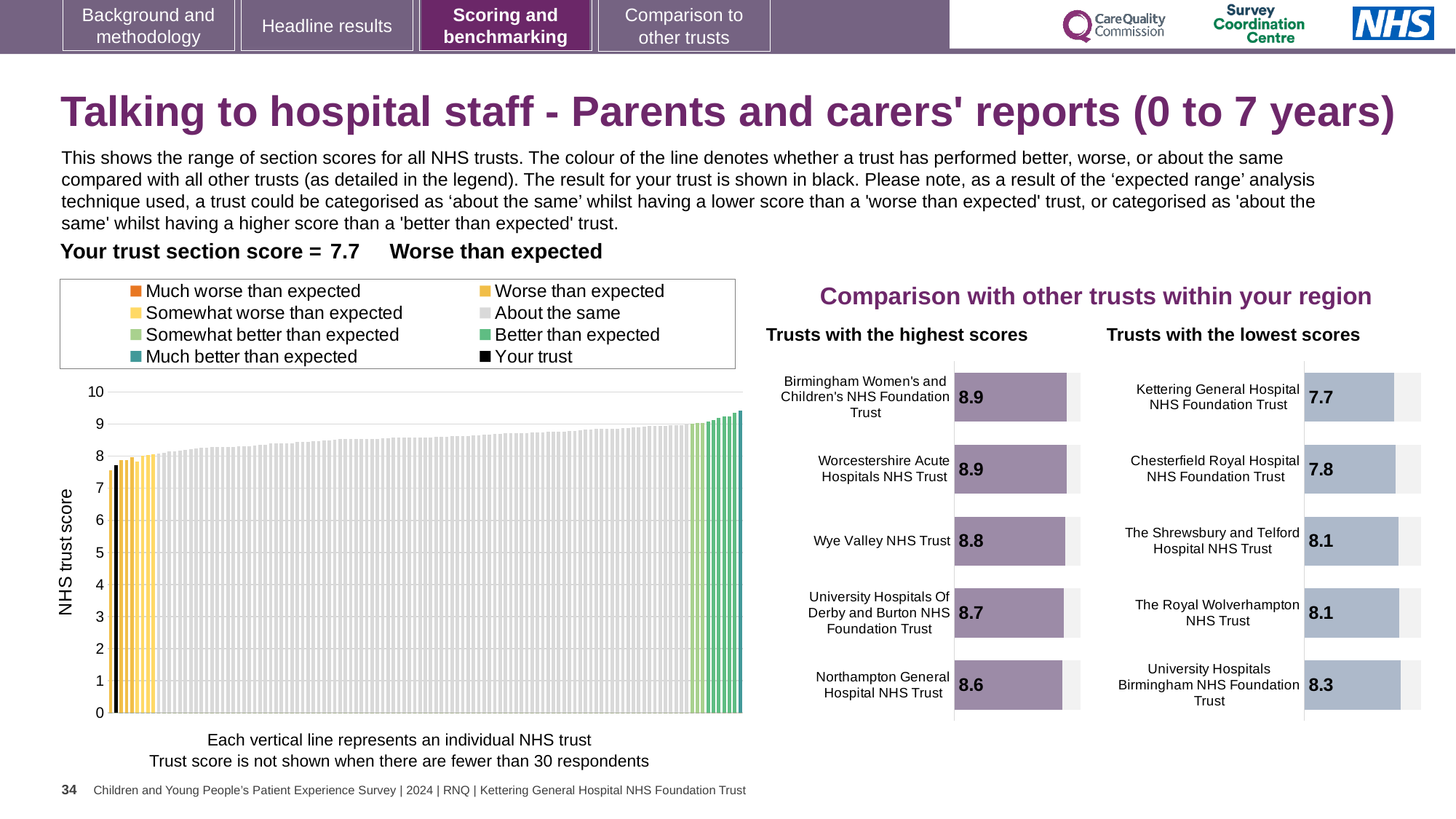
How many trusts are listed in the 'Trusts with the highest scores' chart? 5 In the 'Trusts with the lowest scores' chart, which trust has the lowest score? Kettering General Hospital NHS Foundation Trust How many entries does the legend of the left-hand NHS trust score chart list? 8 In the 'Trusts with the lowest scores' chart, which has the higher score: Kettering General Hospital NHS Foundation Trust or University Hospitals Birmingham NHS Foundation Trust? University Hospitals Birmingham NHS Foundation Trust In the 'Trusts with the highest scores' chart, what is the difference between the scores of Birmingham Women's and Children's NHS Foundation Trust and Northampton General Hospital NHS Trust? 0.3 In the left-hand chart, is the value for Your trust (the black bar) greater or less than 8? less In the 'Trusts with the highest scores' chart, which trust has the lowest score? Northampton General Hospital NHS Trust In the 'Trusts with the lowest scores' chart, what is the score for Chesterfield Royal Hospital NHS Foundation Trust? 7.8 What is the y-axis label of the left-hand chart? NHS trust score What kind of chart is the large chart on the left showing NHS trust scores? Bar chart In the 'Trusts with the highest scores' chart, what is the score for Wye Valley NHS Trust? 8.8 In the 'Trusts with the lowest scores' chart, what is the difference between the scores of University Hospitals Birmingham NHS Foundation Trust and Kettering General Hospital NHS Foundation Trust? 0.6